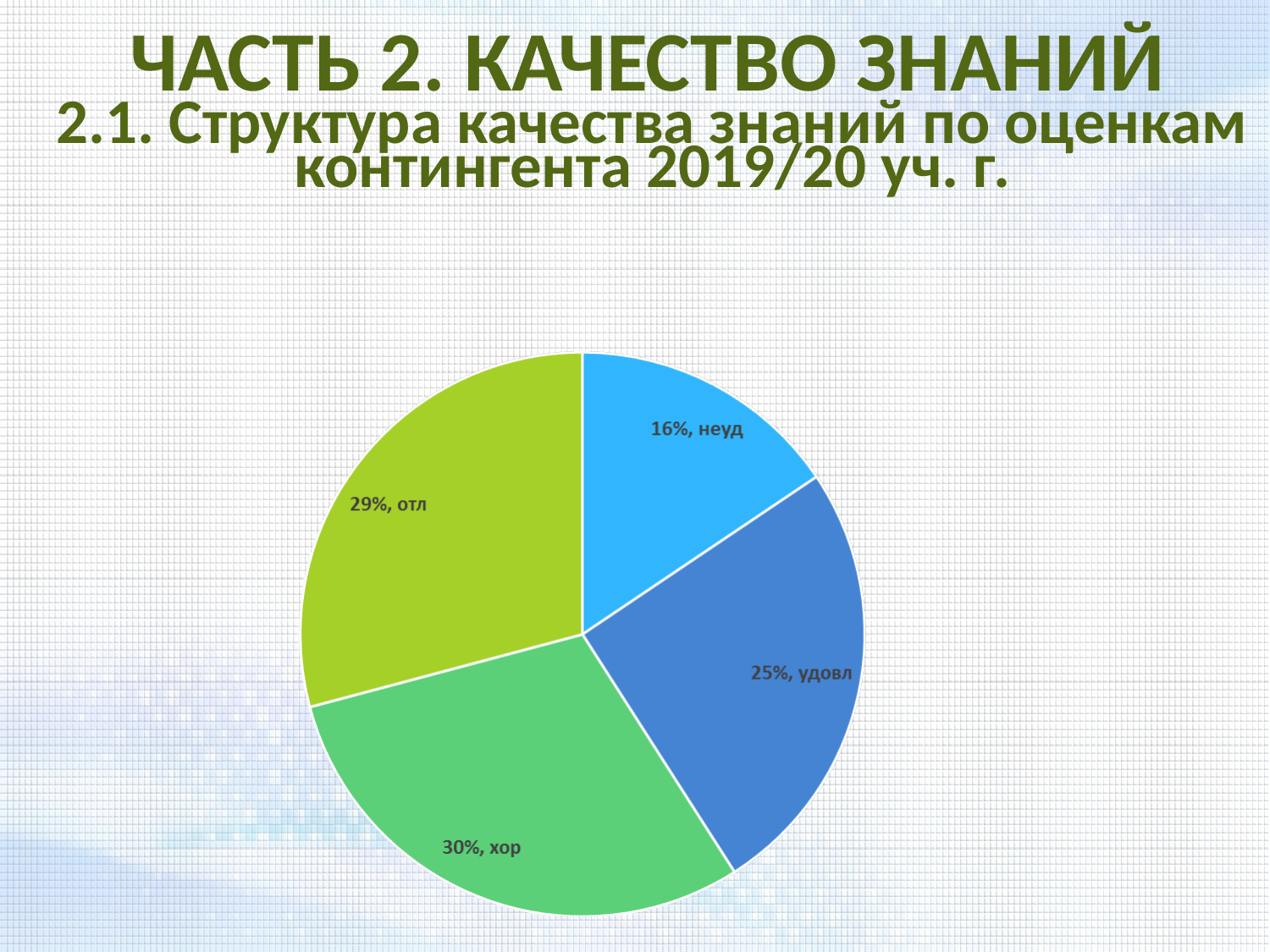
What share of the pie does the "хор" slice represent? 30% What is the difference in percentage points between the "отл" slice and the "удовл" slice? 4 Which slice of the pie chart is the smallest? неуд Which slice of the pie chart is the largest? хор What kind of chart is shown on the slide? pie chart What share of the pie does the "удовл" slice represent? 25% How many slices does the pie chart have? 4 Which is larger, the "удовл" slice or the "неуд" slice? удовл What share of the pie does the "неуд" slice represent? 16% What colour is the "отл" slice of the pie chart? yellow-green What is the difference in percentage points between the "хор" slice and the "неуд" slice? 14